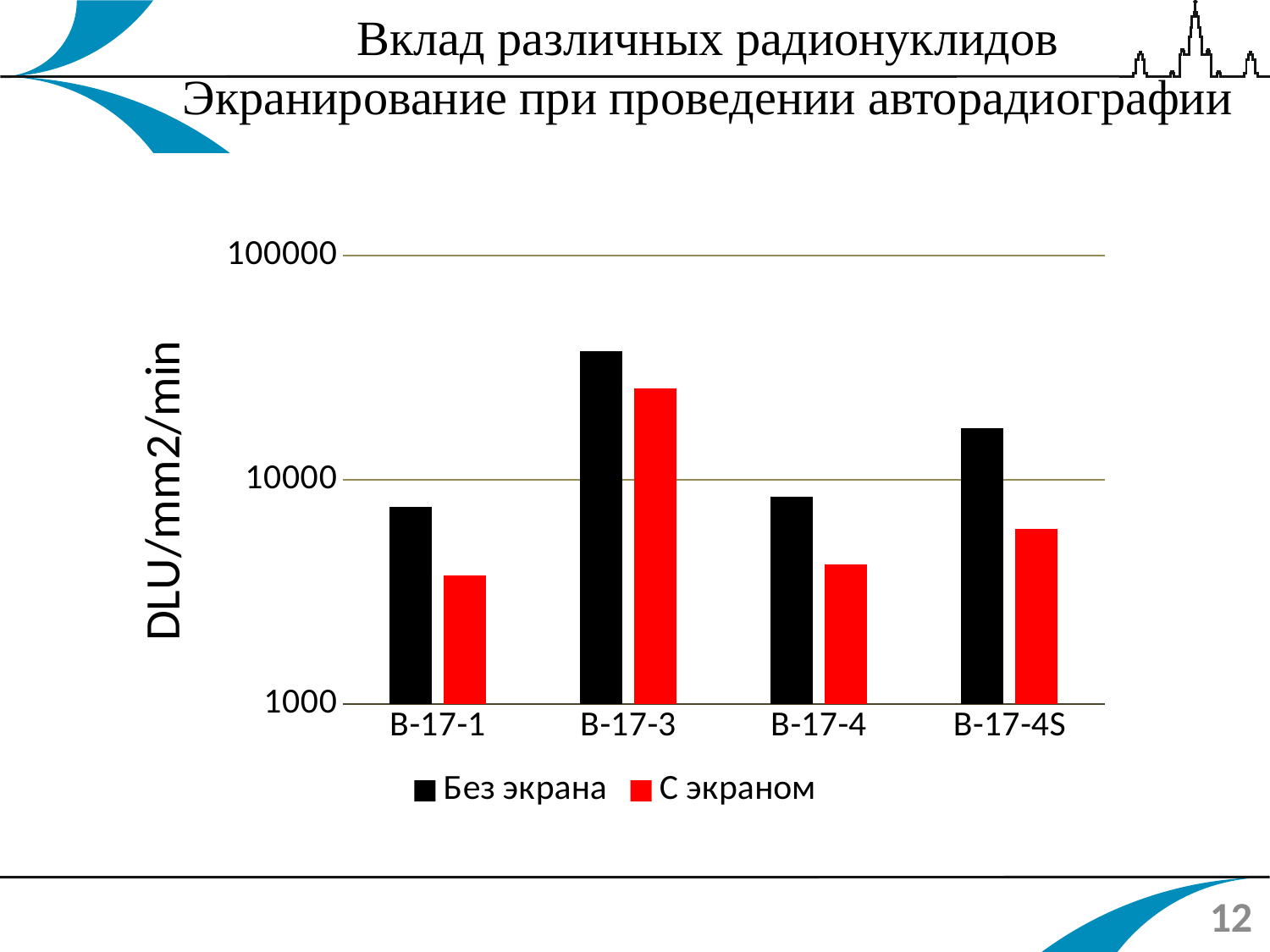
How many categories are shown on the x axis of the chart? 4 At B-17-4, which series has the larger value: 'Без экрана' or 'С экраном'? Без экрана What is the label on the vertical axis of the chart? DLU/mm2/min What kind of chart is shown on the slide? bar chart Which category has the highest value for the series 'Без экрана'? B-17-3 Is the value for 'С экраном' at B-17-4S greater or less than 10000? less Is the value for 'Без экрана' at B-17-4S greater or less than 10000? greater How many series does the chart legend list? 2 Is the value for 'С экраном' at B-17-3 greater or less than 10000? greater Which category has the highest value for the series 'С экраном'? B-17-3 For the series 'Без экрана', which is larger: the value at B-17-3 or the value at B-17-4S? B-17-3